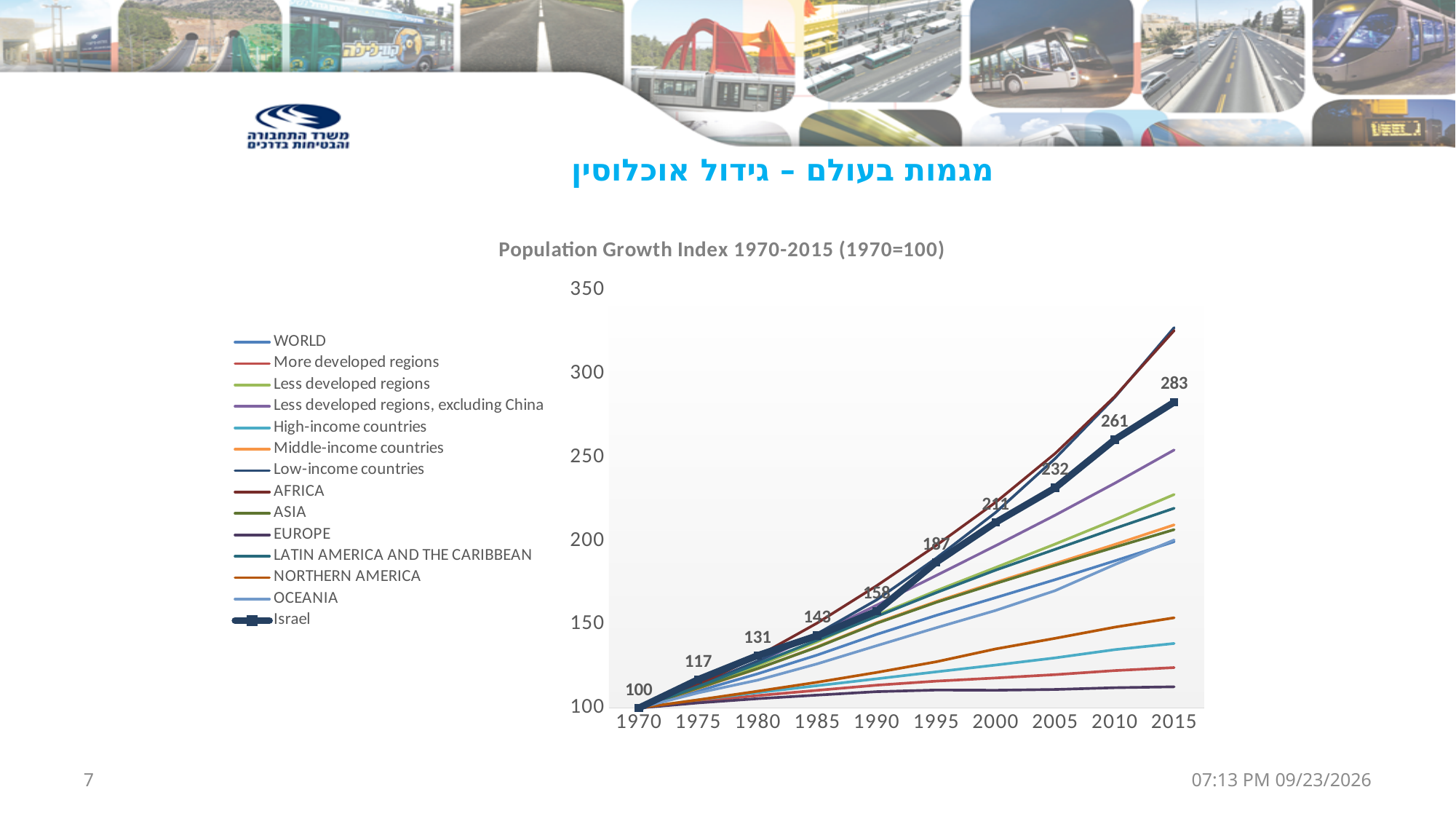
What is the value for Israel in 2005? 232 What is the title of the chart? Population Growth Index 1970-2015 (1970=100) How many years are shown on the x axis? 10 What is the difference between the Israel value in 2015 and in 1970? 183 Is the value for AFRICA in 2015 greater or less than 300? greater What is the value for Israel in 2010? 261 How many series does the legend list? 14 By how much did the Israel index increase between 2010 and 2015? 22 What kind of chart is shown on the slide? line chart What is the value for Israel in 2015? 283 What is the value for Israel in 1975? 117